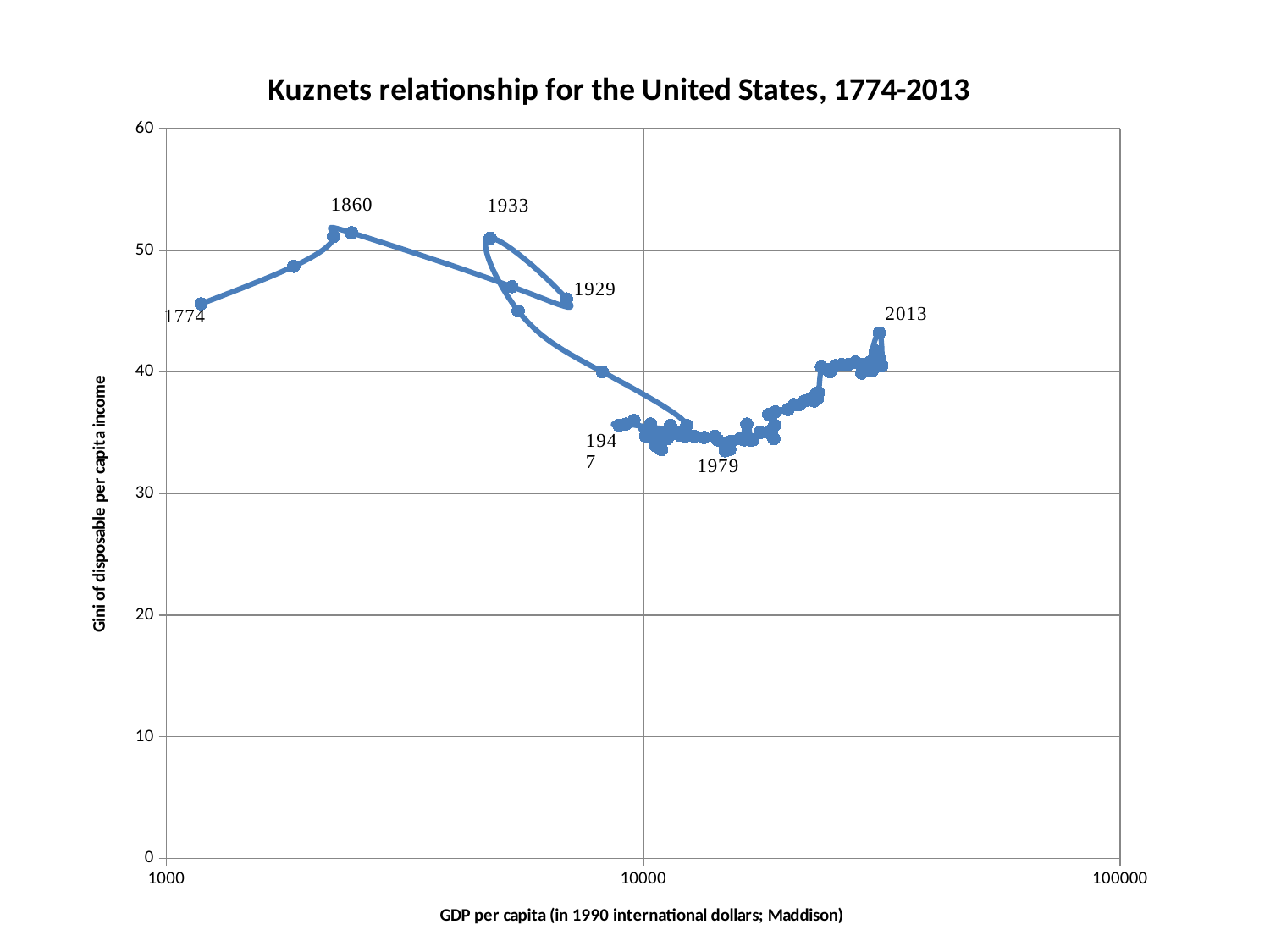
Is the GDP per capita for the point labelled 1774 greater or less than 10000? less What is the label of the vertical axis? Gini of disposable per capita income Is the Gini value for the point labelled 1860 greater or less than 50? greater Which of the labelled points has a higher Gini value, 1860 or 1979? 1860 Is the Gini value for the point labelled 1979 greater or less than 40? less What kind of chart is shown on the slide? scatter chart with connected points (line chart) Among the labelled years, which point has the lowest Gini value? 1979 Which of the labelled points has a higher Gini value, 1774 or 1947? 1774 What is the title of the chart? Kuznets relationship for the United States, 1774-2013